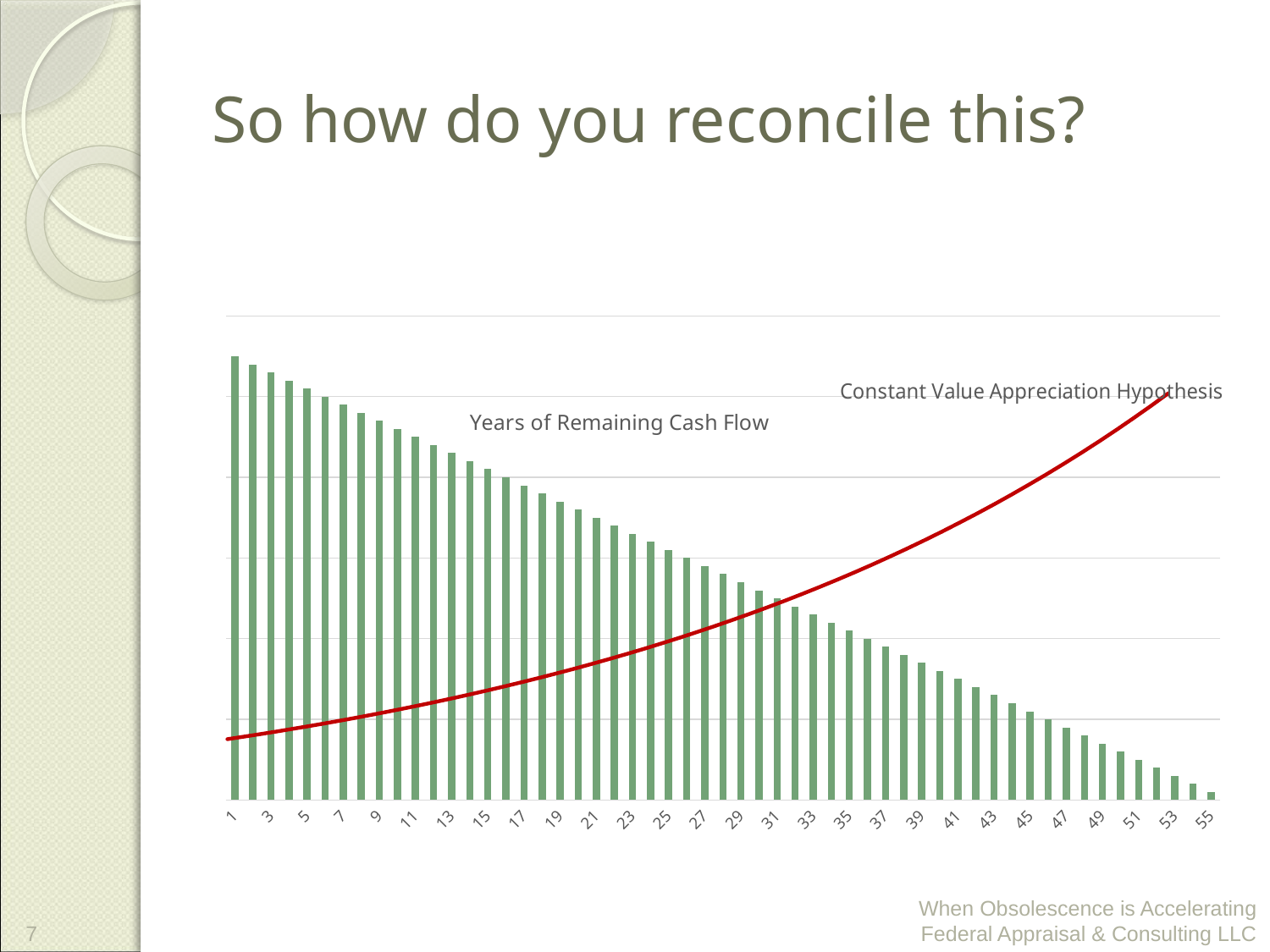
At which x-axis value is the Years of Remaining Cash Flow bar tallest? 1 What kind of chart is used to show the Years of Remaining Cash Flow series? Bar chart How many series are plotted on the chart? 2 What is the title of the slide containing the chart? So how do you reconcile this? Which is taller: the Years of Remaining Cash Flow bar at 11 or the bar at 41? The bar at 11 Do the green bars for Years of Remaining Cash Flow rise or fall as the x axis goes from 1 to 55? Fall What is the last value labelled on the x axis? 55 At which x-axis value is the Years of Remaining Cash Flow bar shortest? 55 What is the name of the series drawn as a red curve? Constant Value Appreciation Hypothesis Which is taller: the Years of Remaining Cash Flow bar at 1 or the bar at 55? The bar at 1 Does the red Constant Value Appreciation Hypothesis line rise or fall from left to right? Rise